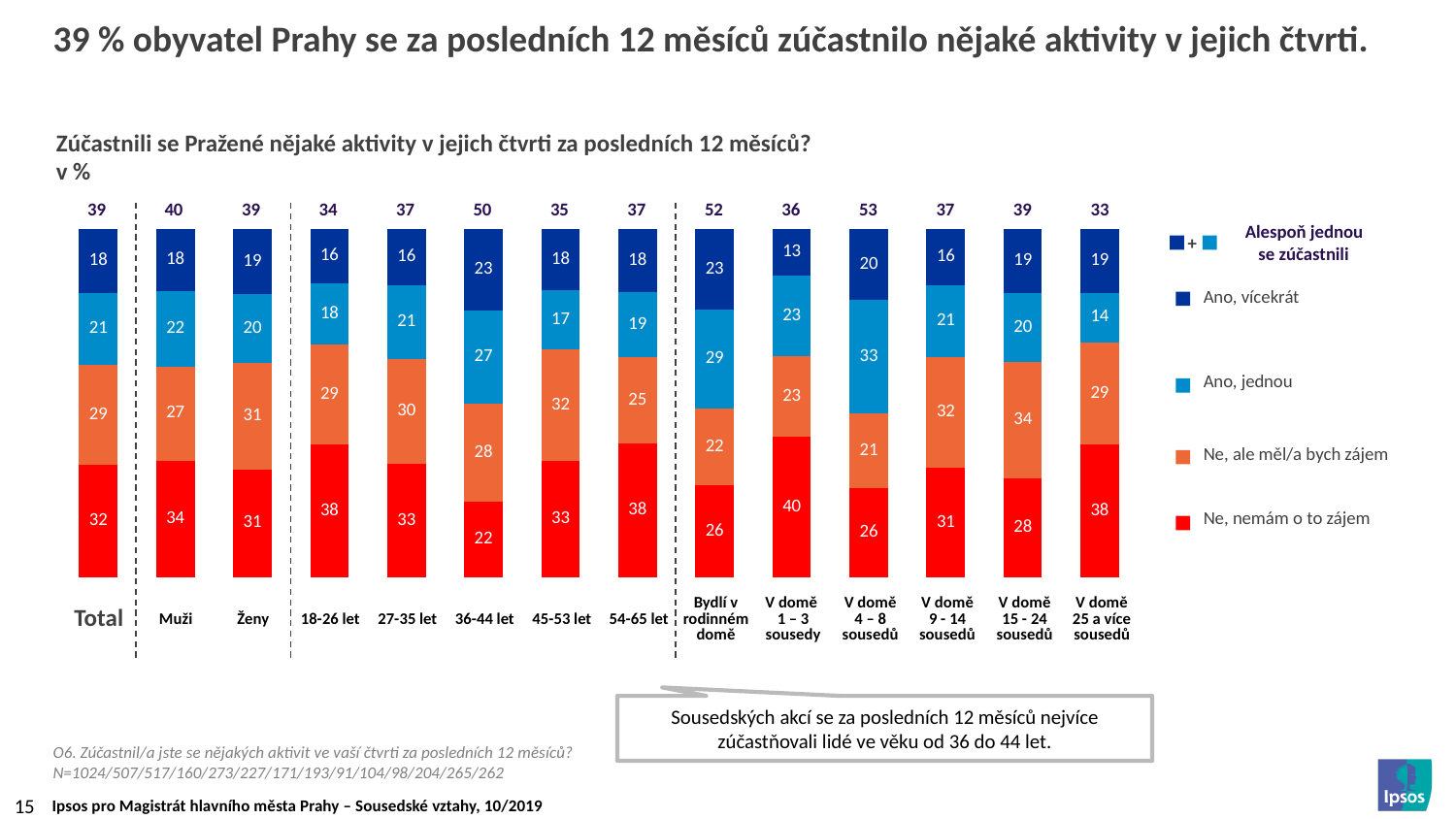
What colour represents the 'Ne, nemám o to zájem' series in the chart? Red What is the value of 'Ne, nemám o to zájem' for the Total category? 32 What is the value of 'Ano, vícekrát' for the 36-44 let category? 23 Which is larger: the 'Ano, jednou' value for 'V domě 4 - 8 sousedů' or for 'V domě 25 a více sousedů'? V domě 4 - 8 sousedů How many categories are shown along the x axis of the chart? 14 How many series does the legend list for the chart? 4 Which category has the lowest 'Alespoň jednou se zúčastnili' value shown above the bars? V domě 25 a více sousedů What is the difference between the 'Ne, nemám o to zájem' values for 'V domě 1 – 3 sousedy' and 36-44 let? 18 What is the value of 'Ne, ale měl/a bych zájem' for the 'V domě 15 - 24 sousedů' category? 34 What type of chart is shown on the slide? Stacked bar chart Which category has the highest 'Alespoň jednou se zúčastnili' value shown above the bars? V domě 4 - 8 sousedů What is the total of the 'Ano, vícekrát' and 'Ano, jednou' segments for the Muži category? 40